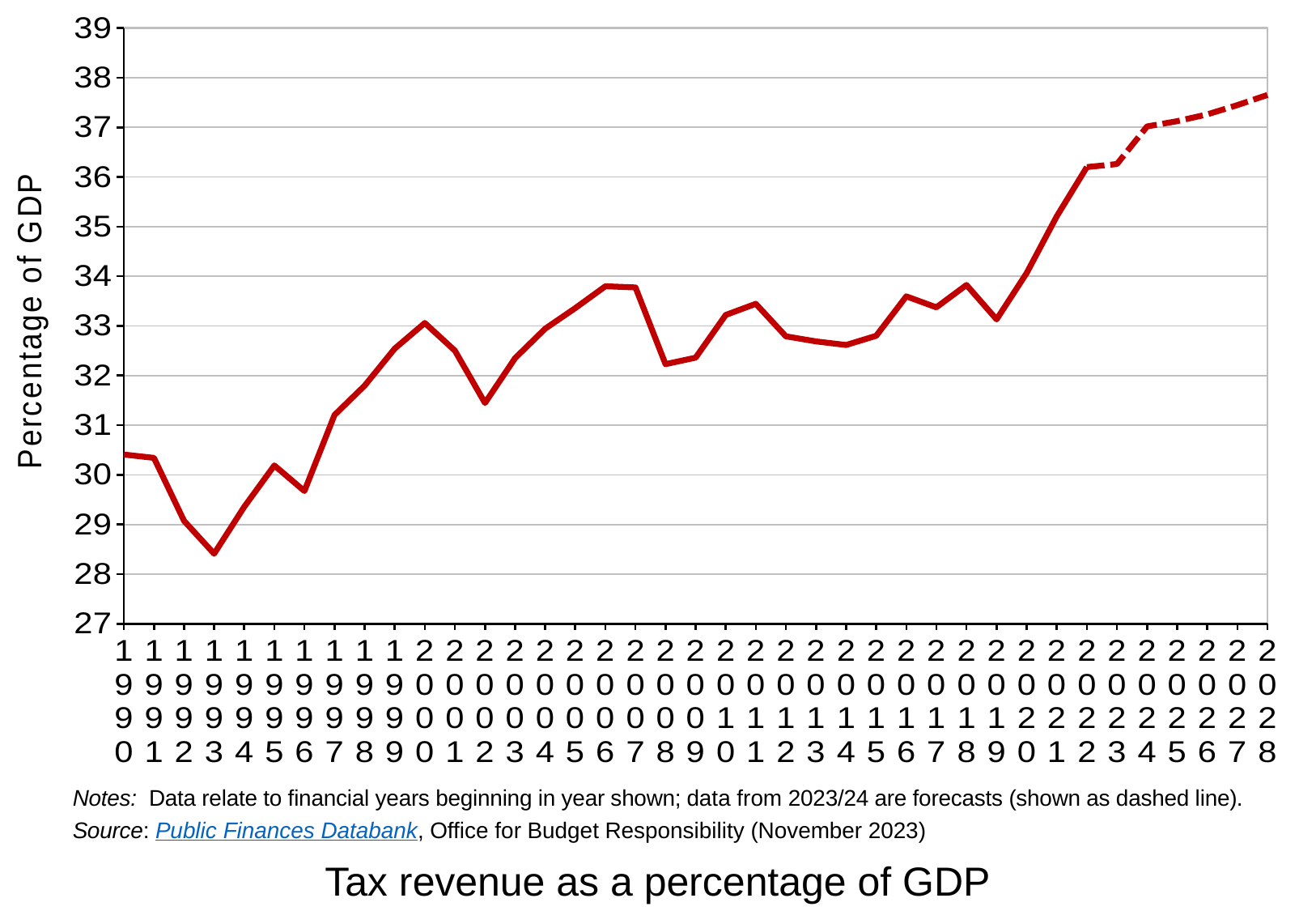
What kind of chart is shown on the slide? line chart Is the value for 2012 greater or less than 32? greater Is the value for 1993 greater or less than 29? less Which year has the higher value, 2016 or 2012? 2016 What does the dashed portion of the line represent, according to the notes? forecasts (data from 2023/24) In which year is tax revenue as a percentage of GDP lowest? 1993 Is the value for 2024 greater or less than 36? greater Does the value rise or fall between 1990 and 1993? fall How many years are plotted along the x axis? 39 In which year is tax revenue as a percentage of GDP highest? 2028 What is the title of the chart? Tax revenue as a percentage of GDP